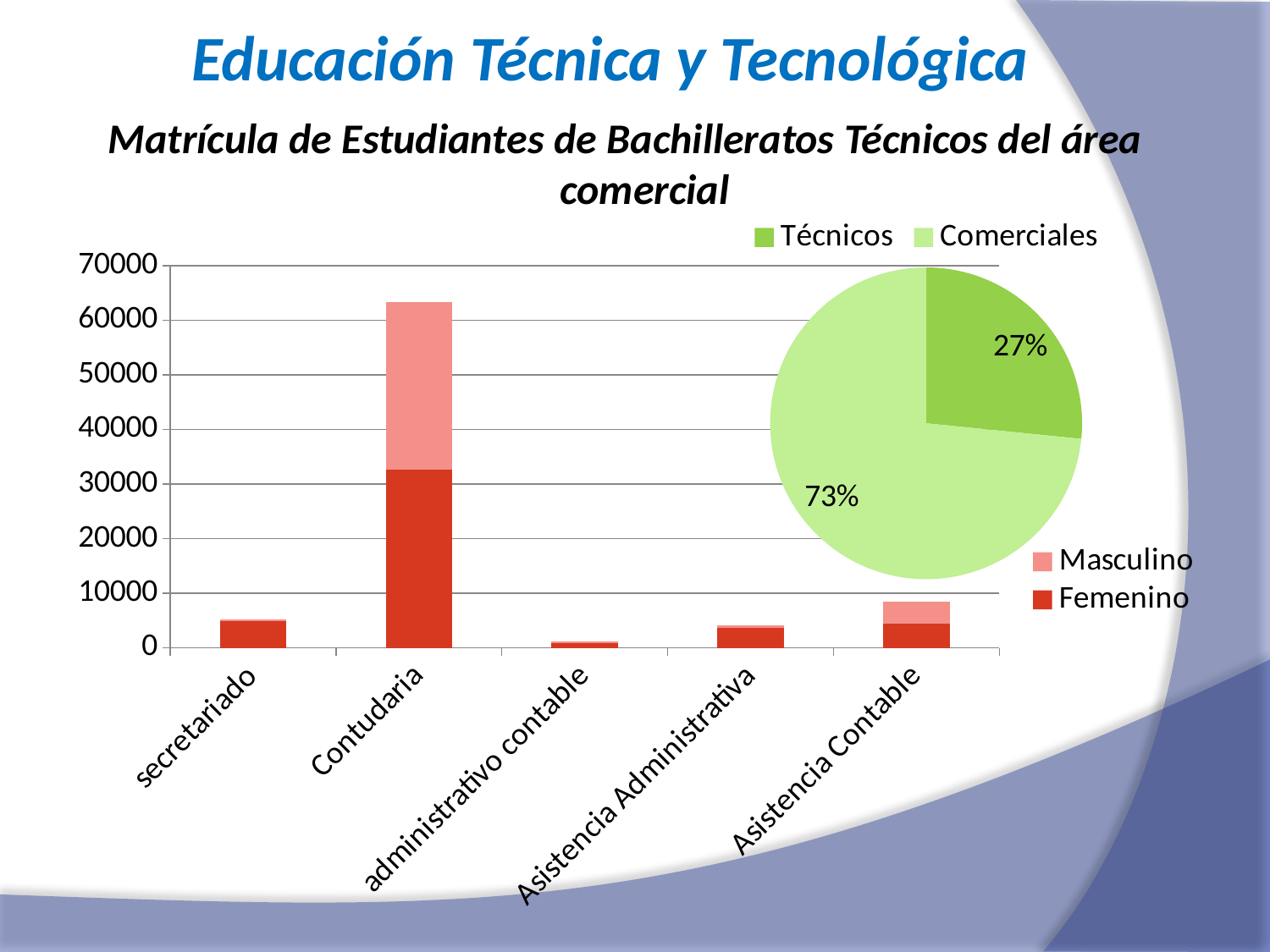
In the bar chart titled 'Matrícula de Estudiantes de Bachilleratos Técnicos del área comercial', is the total stacked value for Contudaria greater or less than 60000? greater In the bar chart titled 'Matrícula de Estudiantes de Bachilleratos Técnicos del área comercial', which category has the shortest stacked bar? administrativo contable In the bar chart titled 'Matrícula de Estudiantes de Bachilleratos Técnicos del área comercial', is the value for secretariado greater or less than 10000? less In the pie chart, how many slices are there? 2 In the bar chart titled 'Matrícula de Estudiantes de Bachilleratos Técnicos del área comercial', which category has the tallest stacked bar? Contudaria In the pie chart, what share is labelled for Técnicos? 27% In the bar chart titled 'Matrícula de Estudiantes de Bachilleratos Técnicos del área comercial', how many categories are shown on the x axis? 5 In the bar chart titled 'Matrícula de Estudiantes de Bachilleratos Técnicos del área comercial', how many series does the legend list? 2 In the pie chart, by how many percentage points does Comerciales exceed Técnicos? 46 What type of chart is the one on the left of the slide, showing Masculino and Femenino? Stacked bar chart In the pie chart, which slice is larger, Técnicos or Comerciales? Comerciales In the pie chart, what share is labelled for Comerciales? 73%